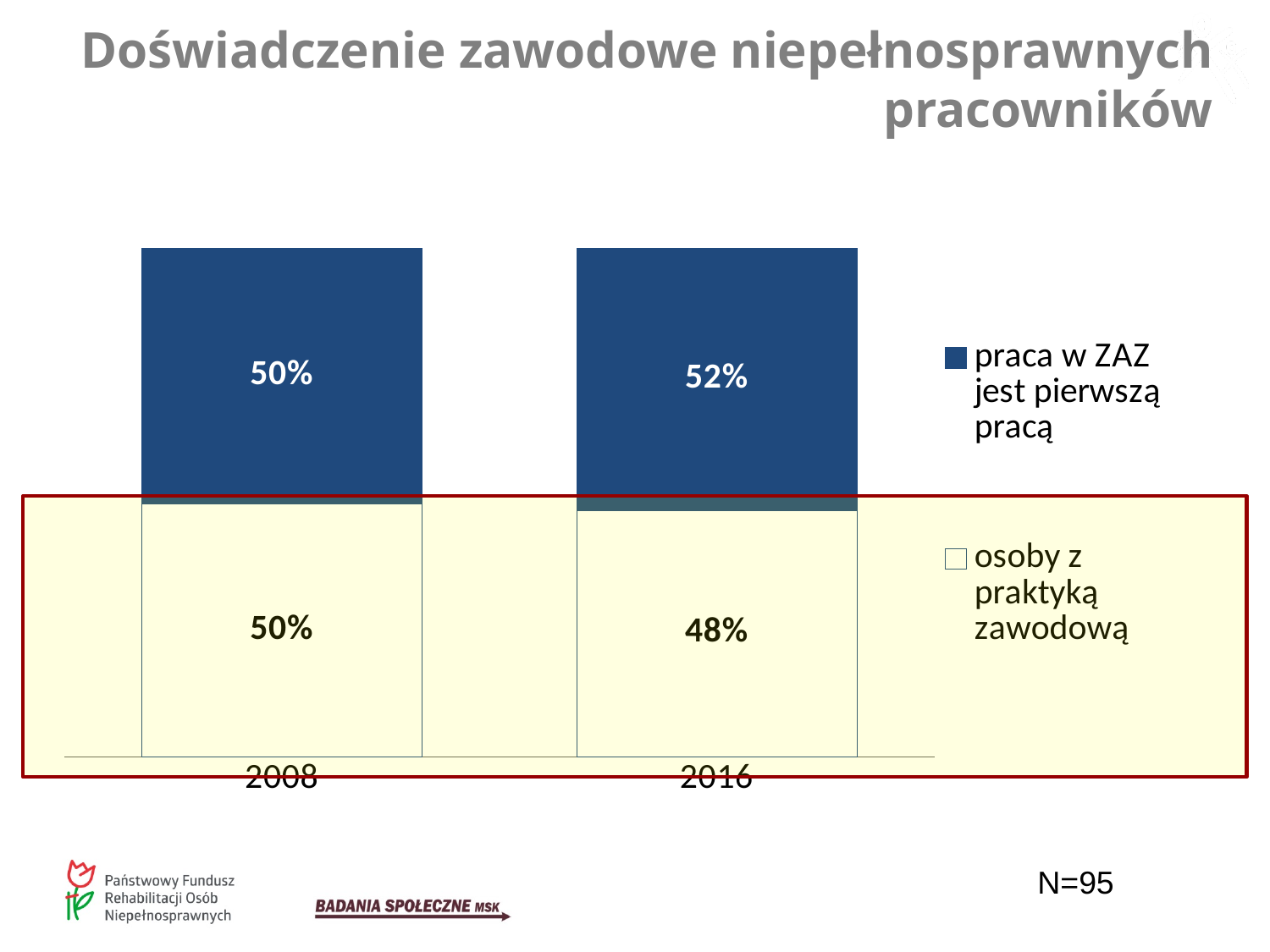
What is the value for "osoby z praktyką zawodową" in 2008? 50% What is the value for "praca w ZAZ jest pierwszą pracą" in 2016? 52% Does the value for "osoby z praktyką zawodową" rise or fall from 2008 to 2016? fall What is the total of the stacked bar for 2016? 100% What is the value for "praca w ZAZ jest pierwszą pracą" in 2008? 50% How many series does the legend list? 2 How many categories are shown on the x axis? 2 What kind of chart is shown on the slide? stacked bar chart What is the sample size (N) stated on the slide? N=95 Which is larger in 2016: "praca w ZAZ jest pierwszą pracą" or "osoby z praktyką zawodową"? praca w ZAZ jest pierwszą pracą What is the value for "osoby z praktyką zawodową" in 2016? 48% What is the difference between the 2016 values for "praca w ZAZ jest pierwszą pracą" and "osoby z praktyką zawodową"? 4 percentage points